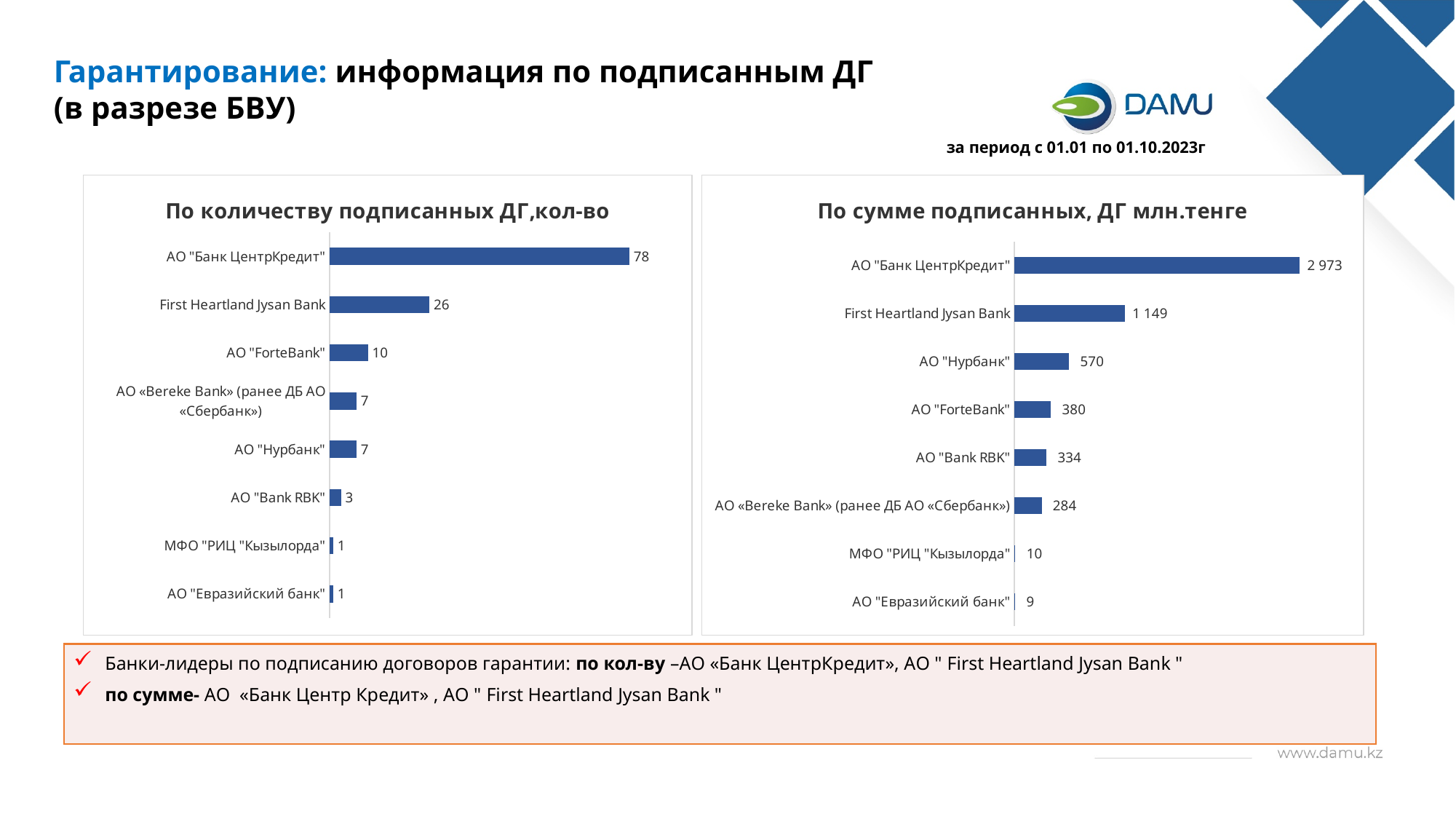
In the chart "По сумме подписанных, ДГ млн.тенге", which category has the lowest value? АО "Евразийский банк" In the chart "По сумме подписанных, ДГ млн.тенге", what is the difference between First Heartland Jysan Bank and АО "Нурбанк"? 579 In the chart "По количеству подписанных ДГ,кол-во", what is the value for АО "Банк ЦентрКредит"? 78 In the chart "По количеству подписанных ДГ,кол-во", how many categories are shown? 8 What kind of chart is "По сумме подписанных, ДГ млн.тенге"? Bar chart In the chart "По количеству подписанных ДГ,кол-во", which category has the highest value? АО "Банк ЦентрКредит" In the chart "По количеству подписанных ДГ,кол-во", what is the value for АО "Bank RBK"? 3 In the chart "По сумме подписанных, ДГ млн.тенге", what is the value for АО "Банк ЦентрКредит"? 2 973 In the chart "По сумме подписанных, ДГ млн.тенге", which is larger: АО "ForteBank" or АО "Bank RBK"? АО "ForteBank" In the chart "По количеству подписанных ДГ,кол-во", what is the value for First Heartland Jysan Bank? 26 In the chart "По количеству подписанных ДГ,кол-во", what is the difference between АО "Банк ЦентрКредит" and First Heartland Jysan Bank? 52 In the chart "По сумме подписанных, ДГ млн.тенге", what is the value for АО "Нурбанк"? 570